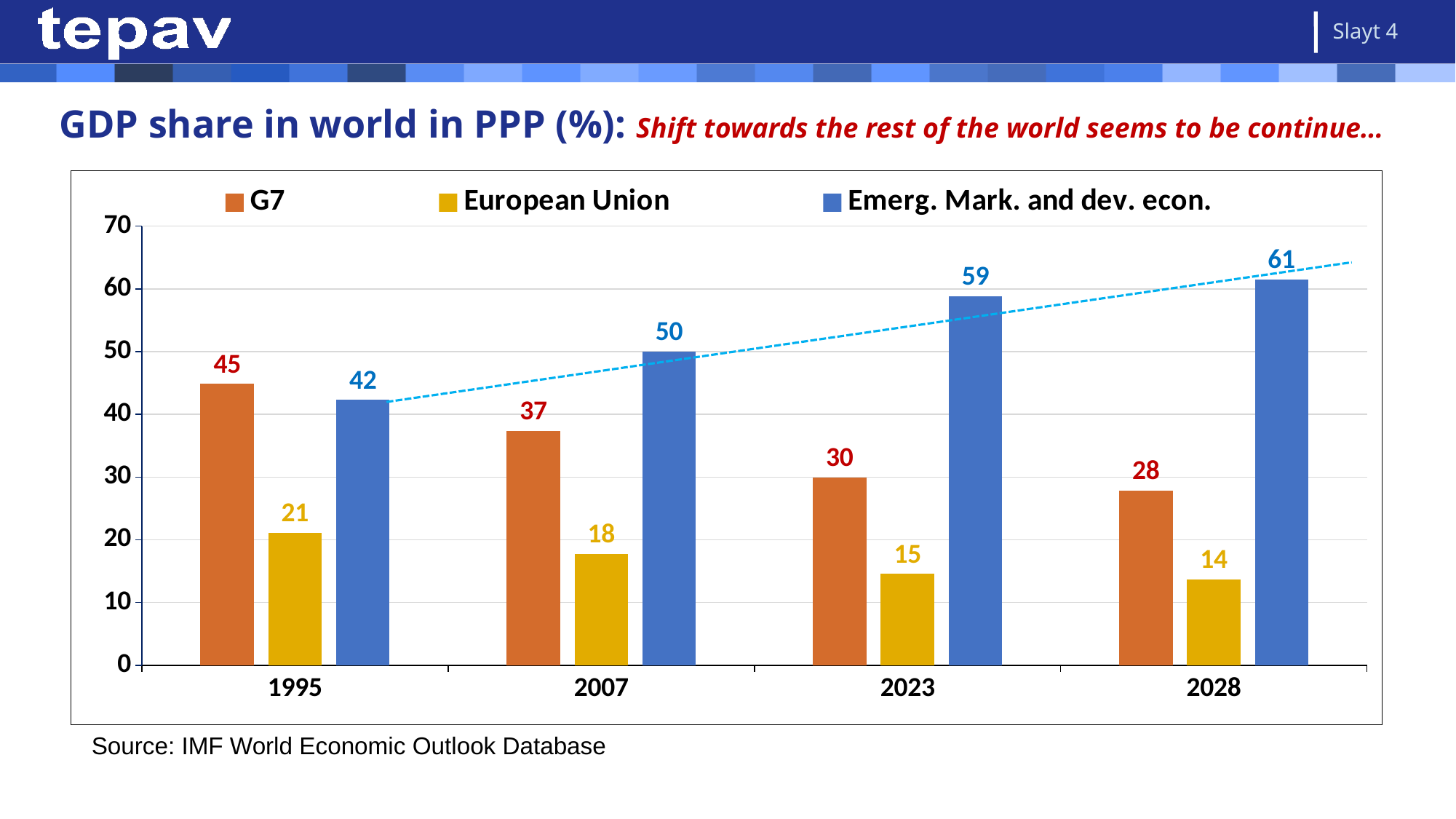
Do the G7 values rise or fall from 1995 to 2028? fall How many series does the legend list? 3 Is the G7 value for 2023 greater or less than 40? less In which year is the Emerg. Mark. and dev. econ. value highest? 2028 In which year is the European Union value lowest? 2028 What is the difference between the G7 value in 1995 and in 2028? 17 Which is larger in 2007: the G7 value or the Emerg. Mark. and dev. econ. value? Emerg. Mark. and dev. econ. What is the G7 value for 1995? 45 What is the value for Emerg. Mark. and dev. econ. in 2028? 61 How many years are shown on the x axis? 4 What is the European Union value for 2023? 15 What kind of chart is shown on the slide? bar chart